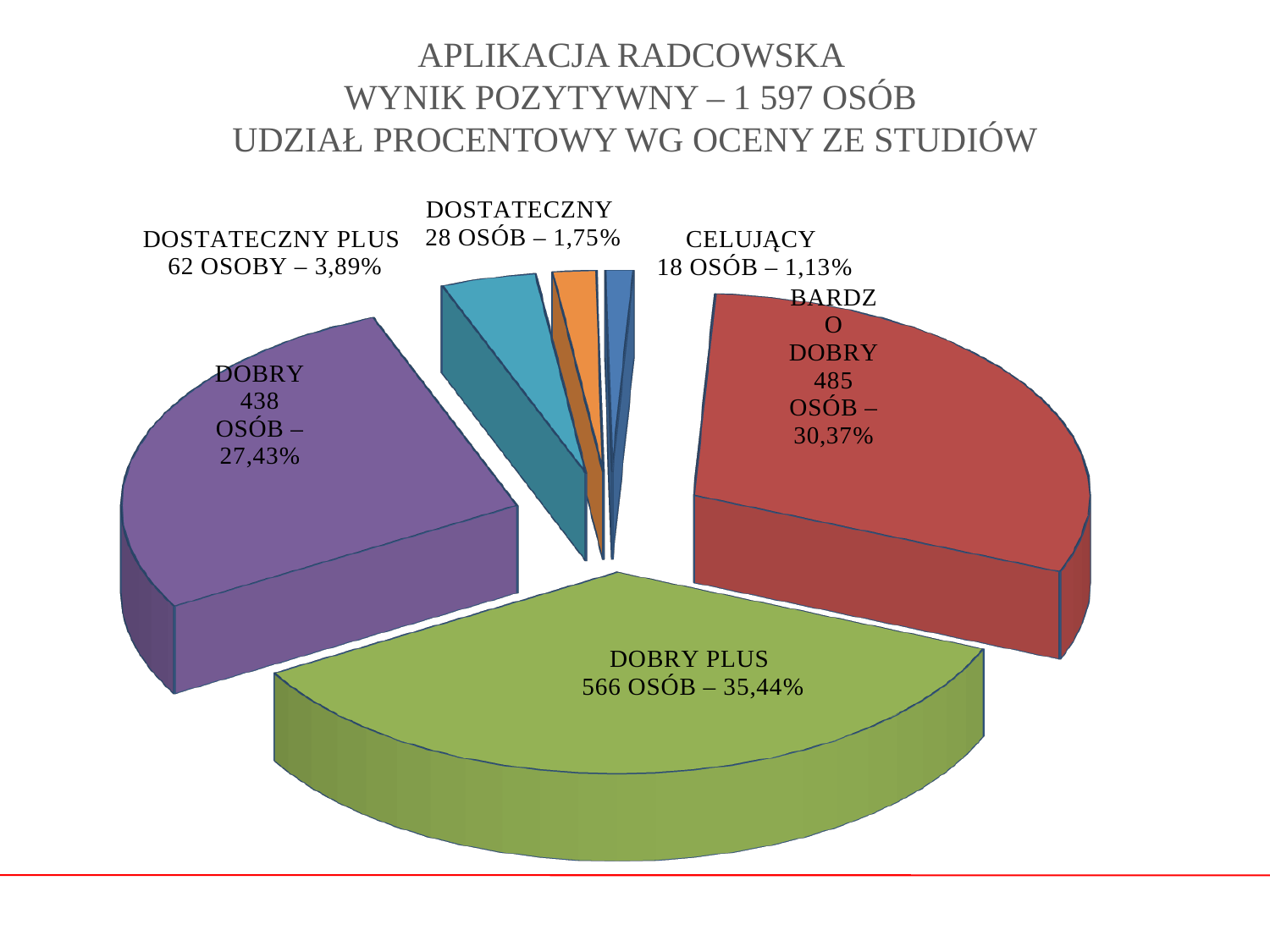
What kind of chart is shown on the slide? pie chart What is the difference in percentage points between DOSTATECZNY and CELUJĄCY? 0,62 Which category has the smallest share of the pie? CELUJĄCY What percentage share does the BARDZO DOBRY slice have? 30,37% Which has more people, DOBRY or BARDZO DOBRY? BARDZO DOBRY Which category has the largest share of the pie? DOBRY PLUS What is the difference in number of people between DOBRY PLUS and BARDZO DOBRY? 81 How many people are in the CELUJĄCY category? 18 How many slices does the pie chart have? 6 How many people are in the DOBRY PLUS category? 566 What total number of people with a positive result is stated in the chart title? 1 597 What percentage share does the DOSTATECZNY PLUS slice have? 3,89%